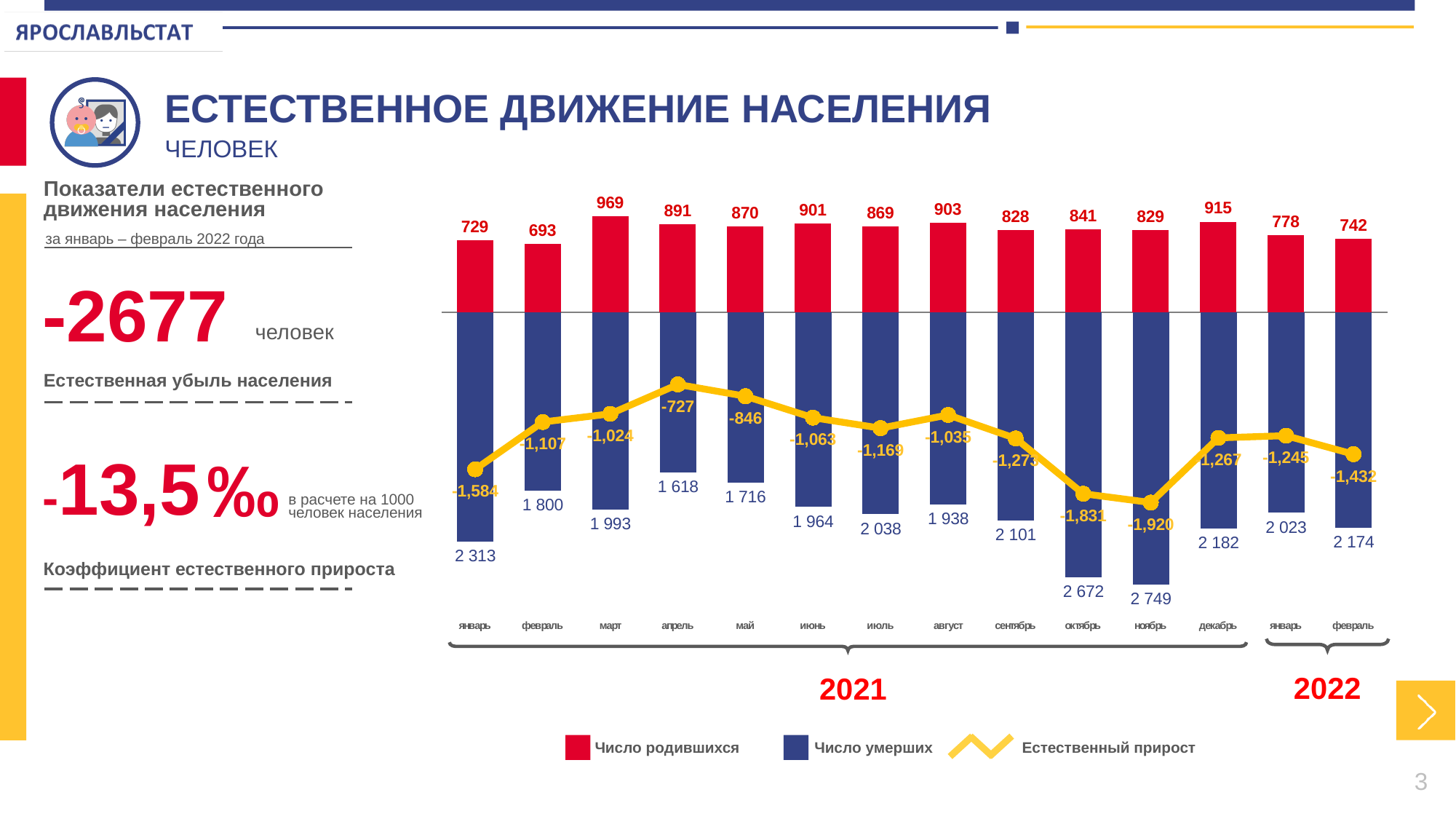
How many months are shown on the x axis of the chart? 14 Do the number of deaths (Число умерших) rise or fall from сентябрь 2021 to ноябрь 2021? Rise What kind of chart is shown on the slide? Bar and line chart What is the number of deaths (Число умерших) for февраль 2022? 2 174 How many series does the chart legend list? 3 In which month is the number of births (Число родившихся) the lowest? февраль 2021 What is the difference between the number of births in март 2021 and февраль 2021? 276 What is the value of Естественный прирост for апрель 2021? -727 How many births (Число родившихся) are shown for март 2021? 969 What is the number of deaths (Число умерших) for ноябрь 2021? 2 749 In which month is the number of deaths (Число умерших) the highest? ноябрь 2021 Which month has more deaths (Число умерших): октябрь 2021 or апрель 2021? октябрь 2021